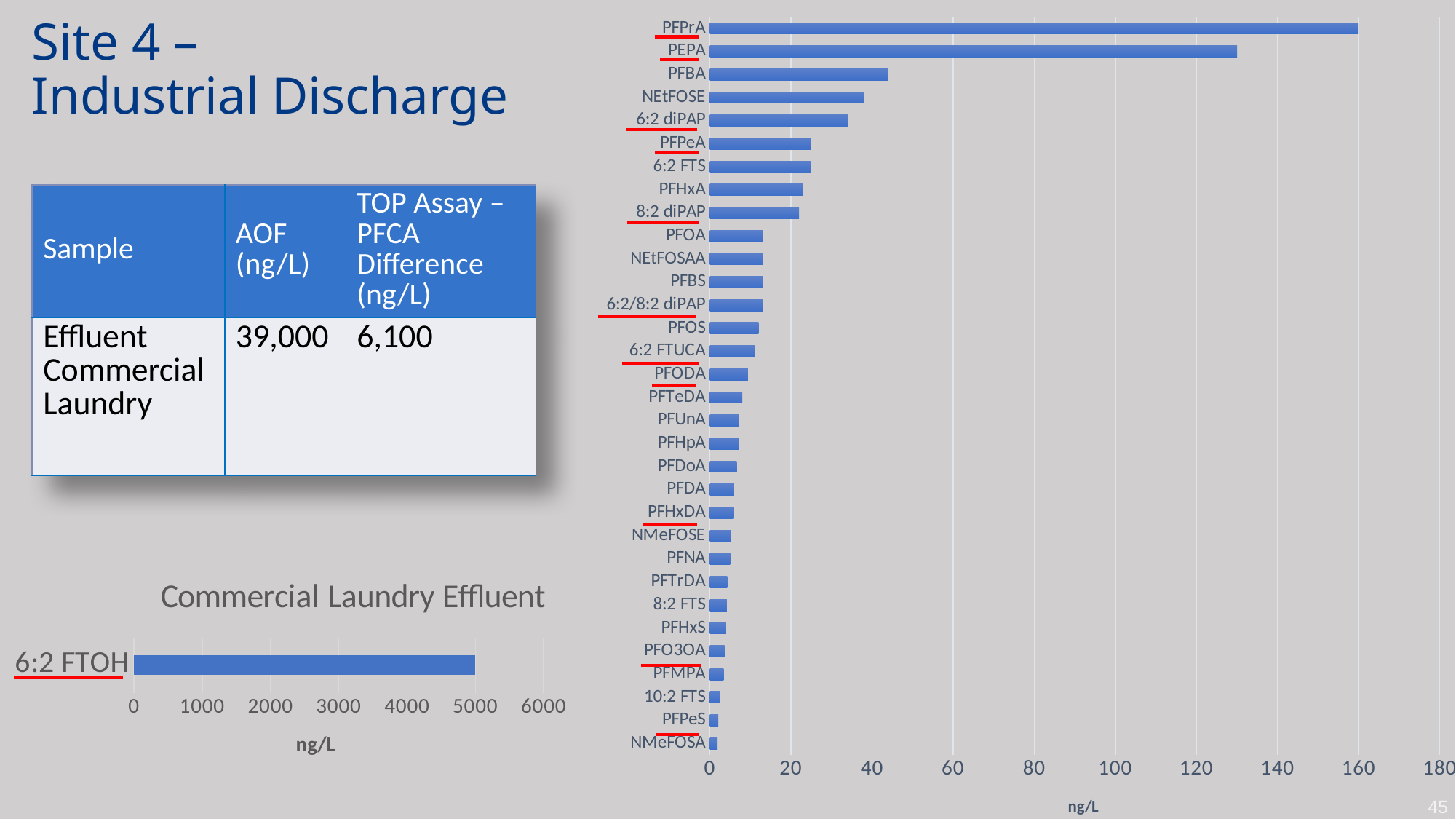
In the large chart on the right, which has the larger value, PEPA or 6:2 diPAP? PEPA In the large chart on the right, is the value for PFPrA greater or less than 140? greater What kind of chart is the large chart on the right side of the slide? bar chart In the 'Commercial Laundry Effluent' chart, what is the value for 6:2 FTOH? 5000 How many compounds are plotted in the large chart on the right? 32 In the large chart on the right, is the value for PFOA greater or less than 20? less What unit is shown on the x axis of the large chart on the right? ng/L In the large chart on the right, which compound has the highest value? PFPrA In the large chart on the right, is the value for PEPA greater or less than 120? greater In the large chart on the right, which compound has the lowest value? NMeFOSA In the large chart on the right, which has the larger value, PFBA or NEtFOSE? PFBA